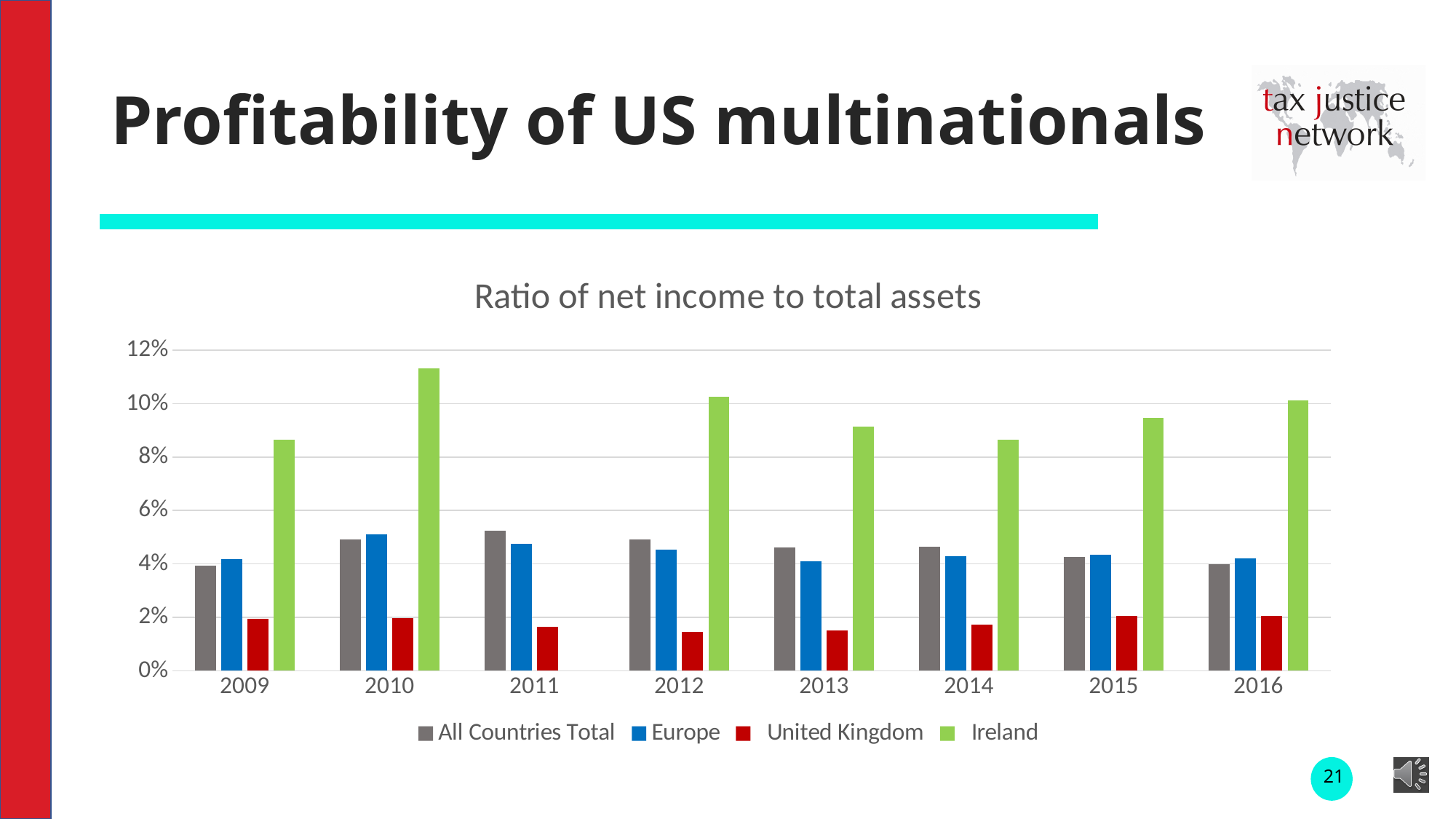
What is the title of the chart? Ratio of net income to total assets Is the value for Ireland in 2010 greater or less than 10%? greater What kind of chart is shown on the slide? bar chart Is the value for Ireland in 2009 greater or less than 8%? greater Is the value for Ireland in 2013 greater or less than 10%? less Which series has the lowest value in 2013? United Kingdom What colour are the Ireland bars? green In which year is the Ireland bar highest? 2010 In 2011, which is larger: All Countries Total or Europe? All Countries Total How many years are shown on the x axis? 8 How many series does the legend list? 4